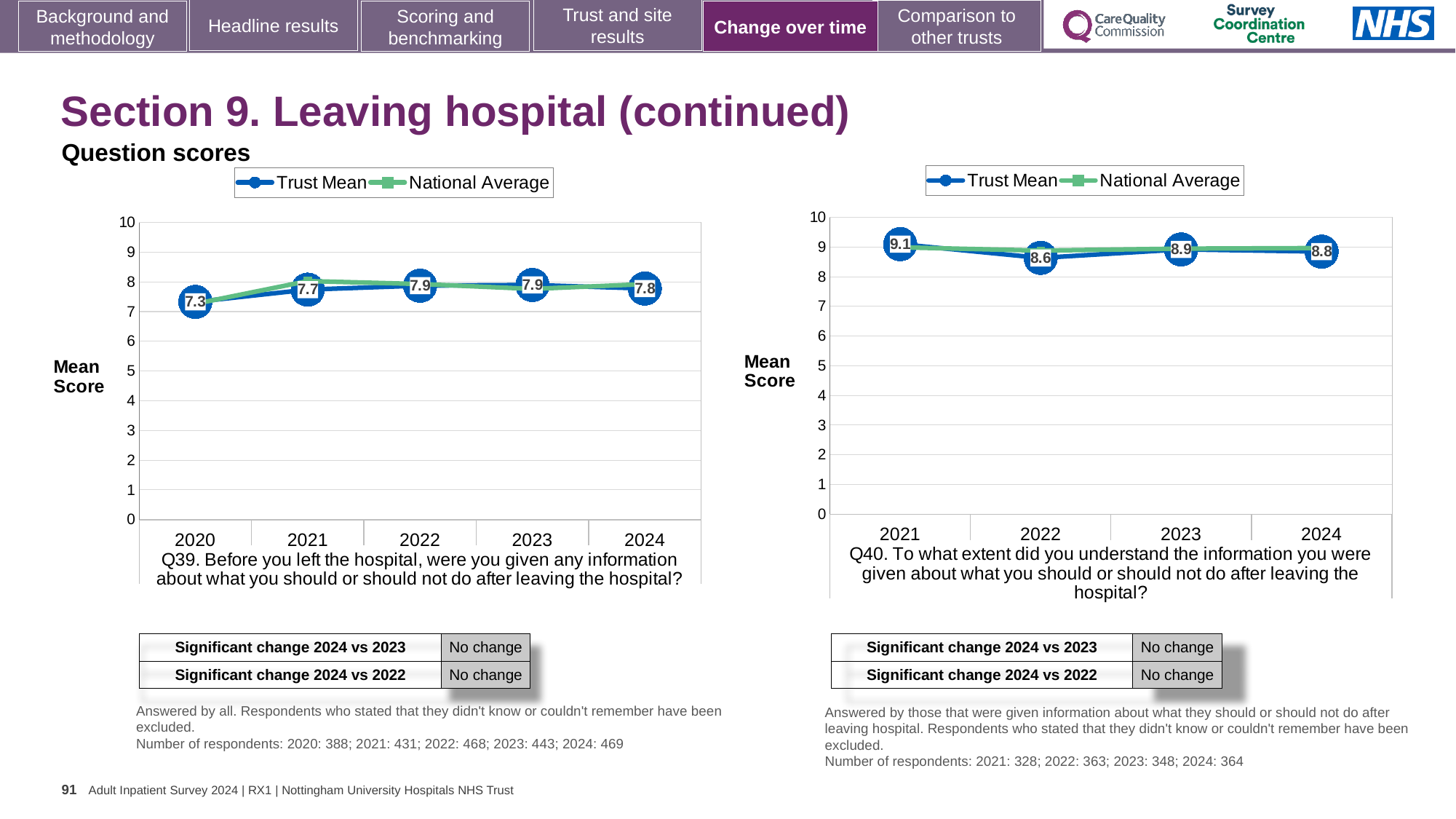
In the Q39 chart (left), which year has the lowest Trust Mean score? 2020 What type of chart is the Q39 chart (left)? Line chart In the Q40 chart (right), is the Trust Mean score higher in 2023 or in 2022? 2023 In the Q40 chart (right), which year has the highest Trust Mean score? 2021 In the Q40 chart (right), what is the Trust Mean score for 2022? 8.6 How many series does the legend of the Q39 chart (left) list? 2 How many years are shown on the x axis of the Q40 chart (right)? 4 In the Q39 chart (left), what is the Trust Mean score for 2020? 7.3 In the Q39 chart (left), is the Trust Mean value for 2021 greater or less than 8? less In the Q39 chart (left), what is the difference between the Trust Mean scores for 2022 and 2020? 0.6 In the Q40 chart (right), what is the difference between the Trust Mean scores for 2021 and 2022? 0.5 In the Q39 chart (left), what is the Trust Mean score for 2024? 7.8